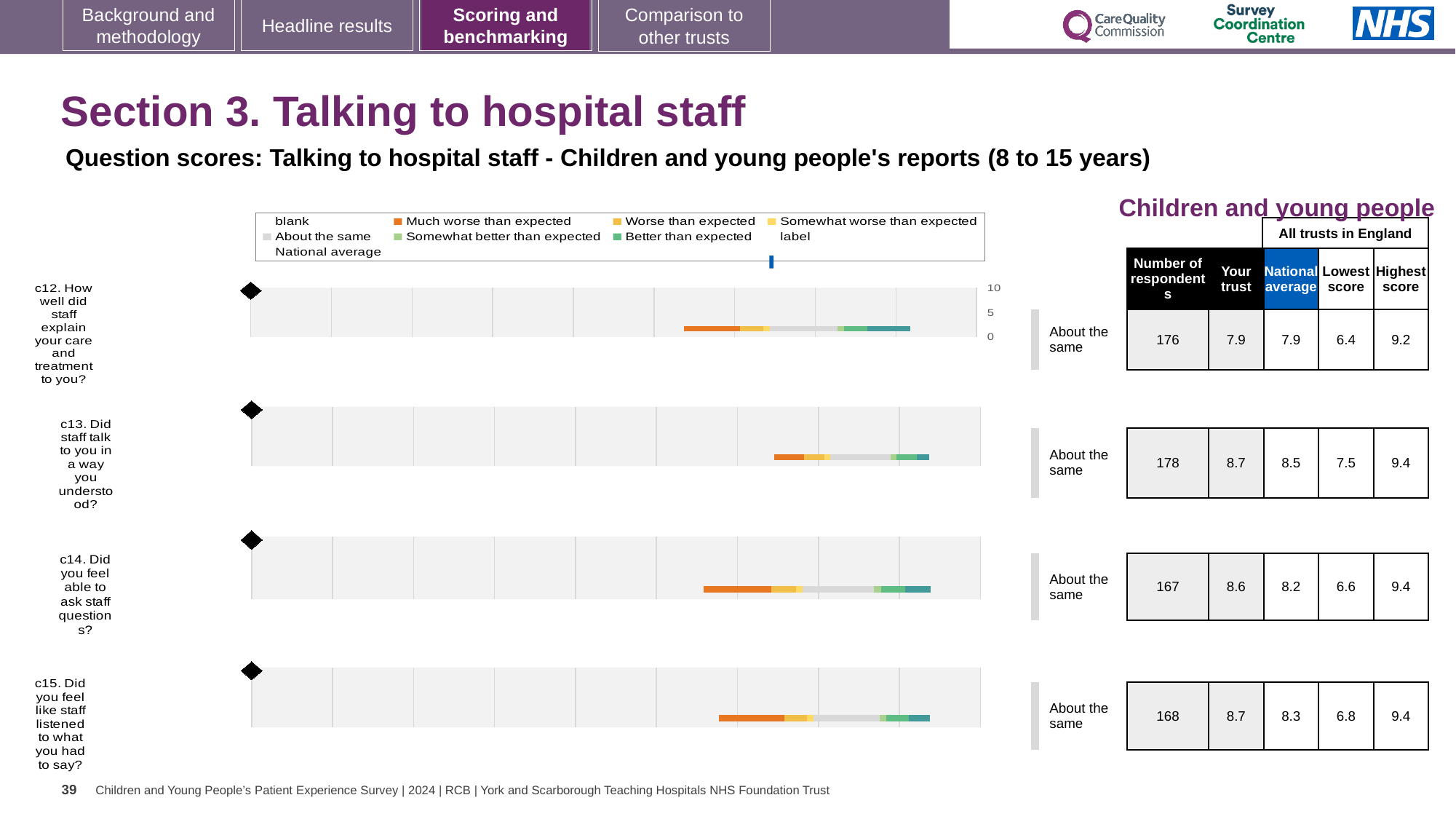
For c15, which is larger: the 'Your trust' score or the national average? Your trust What is the lowest score across all trusts in England for c15? 6.8 In the table next to the charts, how many respondents are listed for c12 (How well did staff explain your care and treatment to you?)? 176 In the table next to the charts, what is the 'Your trust' score for c13 (Did staff talk to you in a way you understood?)? 8.7 What benchmark category label is shown beside the chart for c12? About the same For c14, what is the difference between the 'Your trust' score and the national average? 0.4 In the table next to the charts, what is the national average for c14 (Did you feel able to ask staff questions?)? 8.2 What kind of chart is used to show the benchmark ranges for questions c12 to c15? Bar chart How many questions (c12 to c15) have a benchmark bar chart on this slide? 4 Which question has the lowest 'Your trust' score in the table? c12 What is the highest score across all trusts in England for c12? 9.2 In the chart legend, what colour represents 'Much worse than expected'? Orange